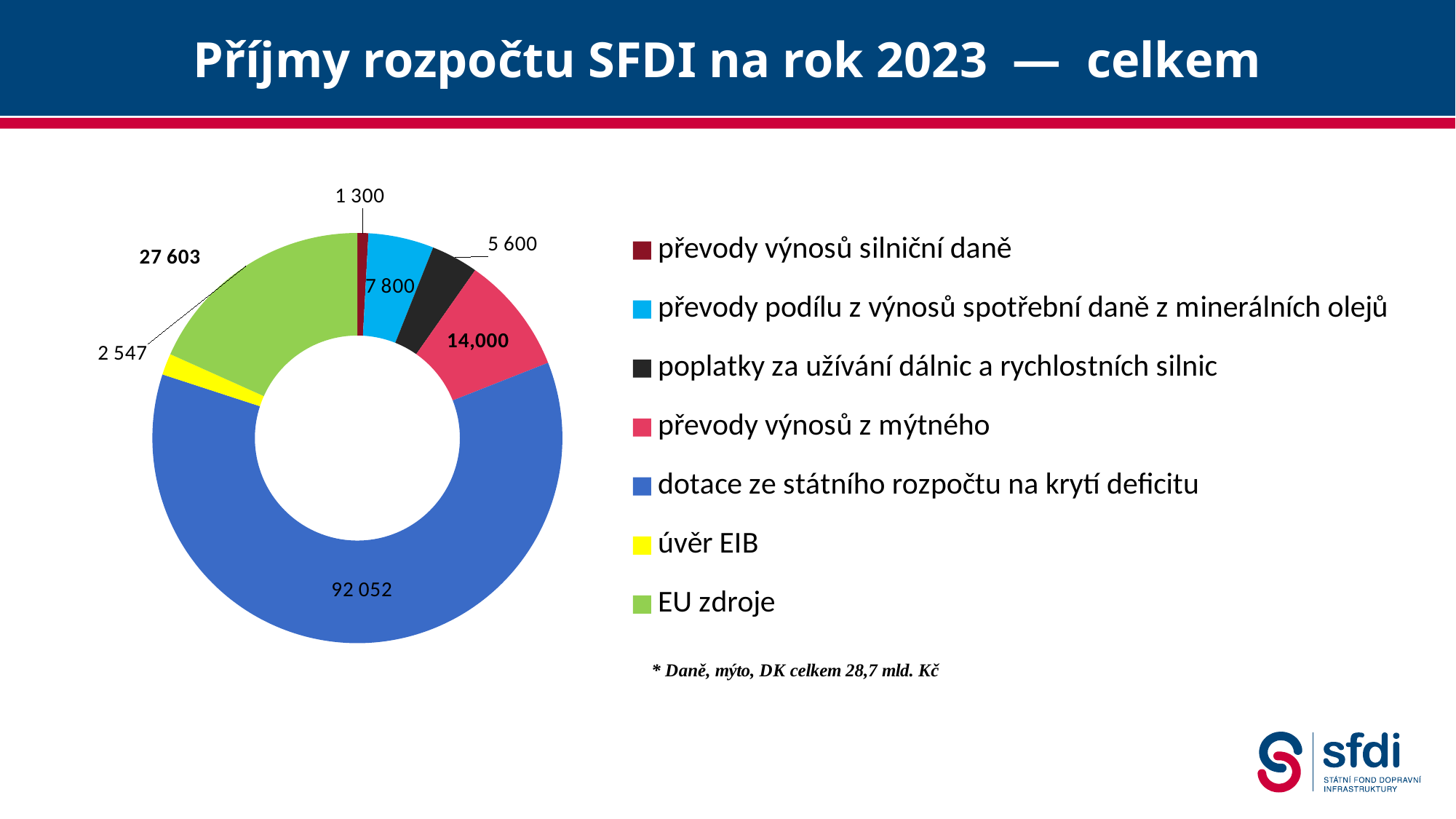
What is the value for 'EU zdroje'? 27 603 What kind of chart is shown on the slide? doughnut chart How many categories does the legend list? 7 What is the title of the slide? Příjmy rozpočtu SFDI na rok 2023 — celkem What is the value for 'úvěr EIB'? 2 547 Which category has the smallest value? převody výnosů silniční daně What is the value for 'poplatky za užívání dálnic a rychlostních silnic'? 5 600 Which category has the largest value? dotace ze státního rozpočtu na krytí deficitu Which is larger: 'převody podílu z výnosů spotřební daně z minerálních olejů' or 'poplatky za užívání dálnic a rychlostních silnic'? převody podílu z výnosů spotřební daně z minerálních olejů What is the value for 'převody výnosů z mýtného'? 14,000 What is the value for 'dotace ze státního rozpočtu na krytí deficitu'? 92 052 What is the difference between 'dotace ze státního rozpočtu na krytí deficitu' and 'EU zdroje'? 64 449